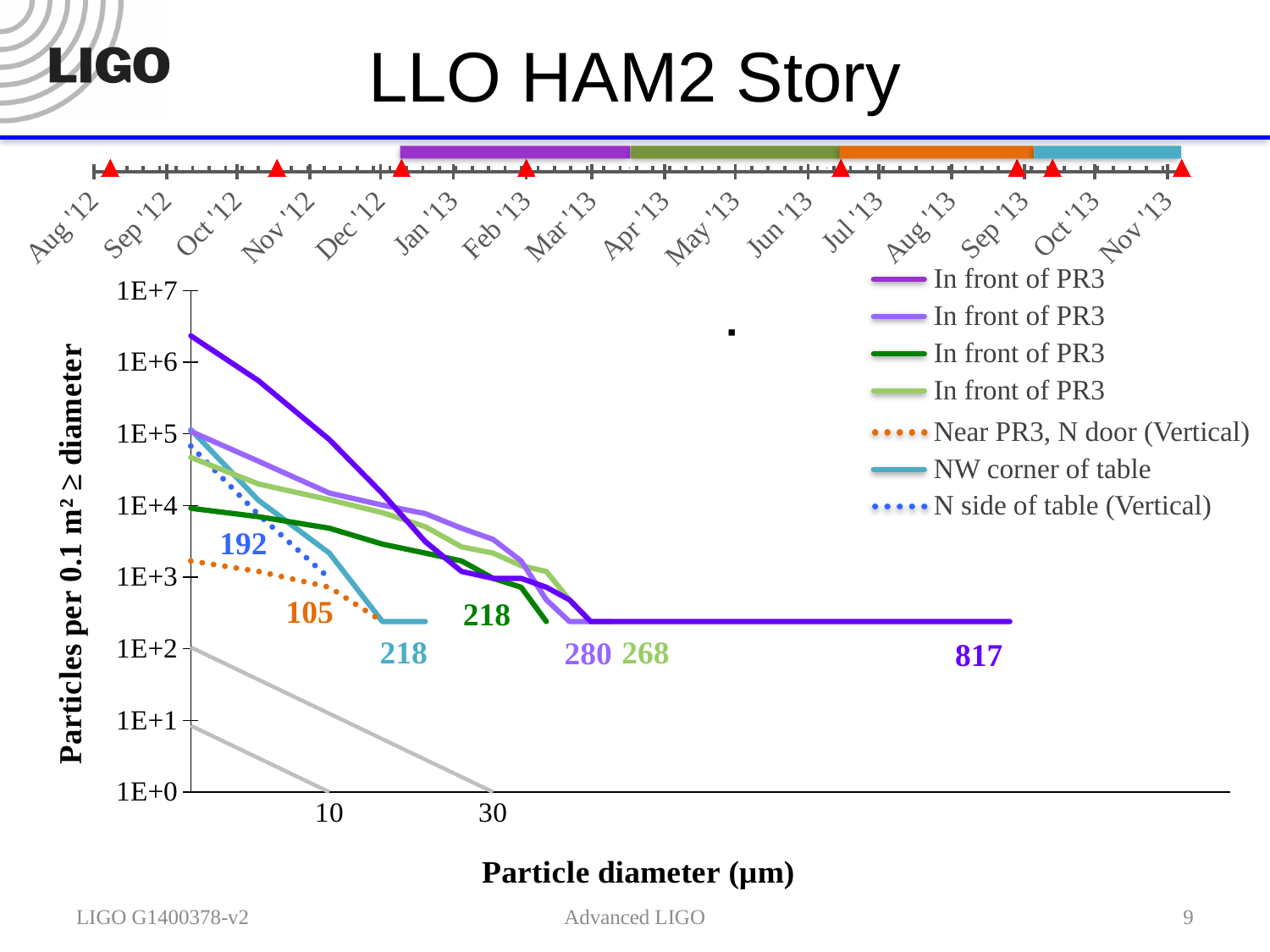
What is the title of the x axis of the chart? Particle diameter (µm) Is the value of the 'Near PR3, N door (Vertical)' line at the smallest particle diameter greater or less than 1E+4? less What is the title of the y axis of the chart? Particles per 0.1 m² ≥ diameter Do the plotted particle counts rise or fall as particle diameter increases along the x axis? fall What number is printed next to the end of the 'NW corner of table' line? 218 Is the value of the dark purple 'In front of PR3' line at the smallest particle diameter greater or less than 1E+6? greater What number is printed next to the end of the 'N side of table (Vertical)' dotted line? 192 What kind of chart is shown on the slide? line chart How many series does the chart legend list? 7 What number is printed next to the end of the 'Near PR3, N door (Vertical)' dotted line? 105 Which of the two printed end labels is larger: the one for the light purple line (280) or the one for the light green line (268)? 280 What number is printed next to the end of the longest line, which extends furthest to the right? 817